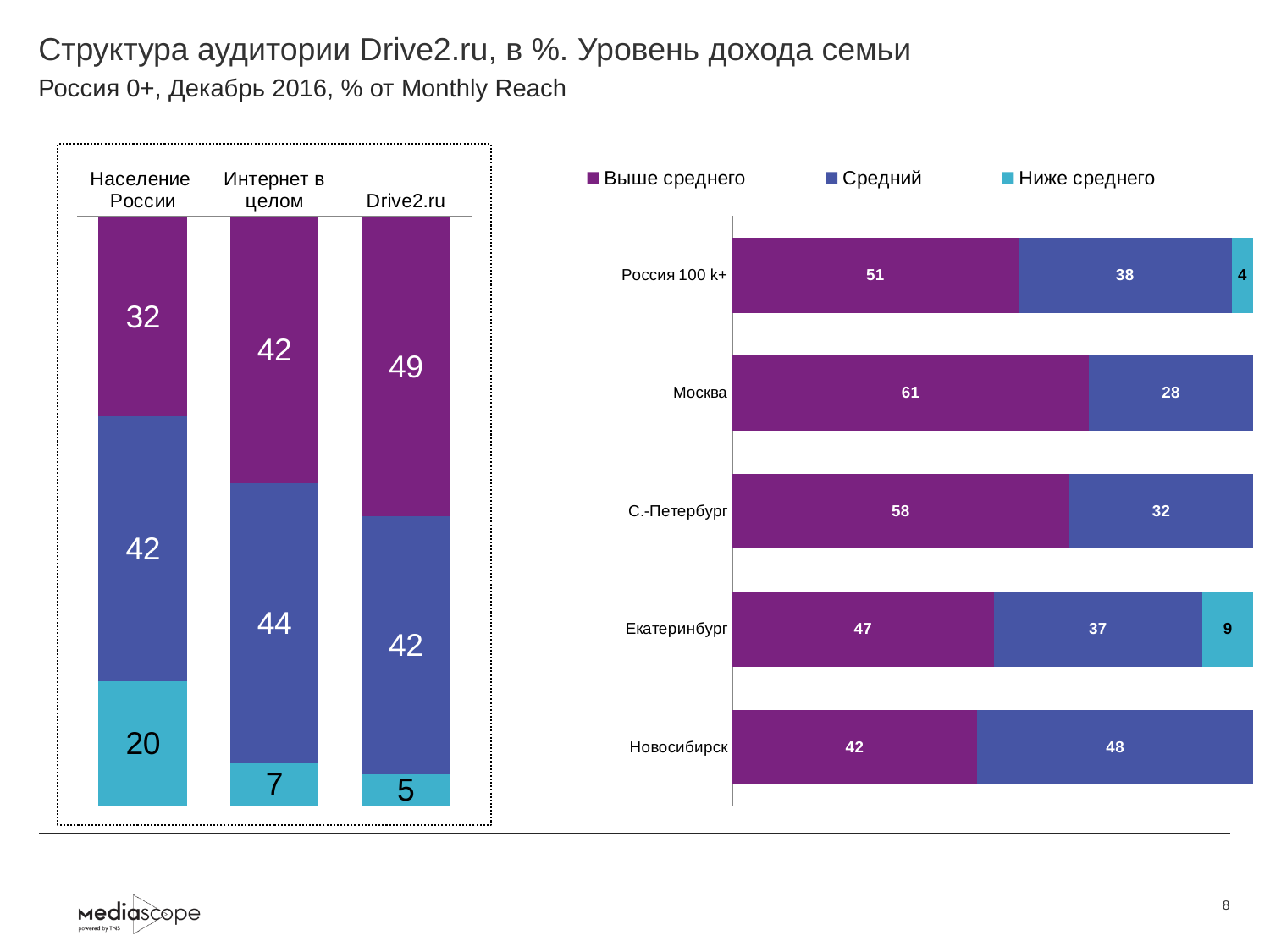
In the right chart, what is the 'Выше среднего' value for Москва? 61 In the right chart, what is the total of the labelled segments for Екатеринбург? 93 In the left chart, what is the value of the 'Средний' segment for Интернет в целом? 44 In the right chart, which city has the highest 'Выше среднего' value? Москва How many series does the legend of the right chart list? 3 In the left chart, which has a larger 'Выше среднего' value: Drive2.ru or Интернет в целом? Drive2.ru In the right chart, what is the 'Ниже среднего' value for Екатеринбург? 9 In the right chart, which category has the lowest 'Выше среднего' value? Новосибирск In the right chart, what is the difference between the 'Выше среднего' values for Москва and Новосибирск? 19 In the left chart, what is the value of the 'Ниже среднего' segment for Население России? 20 How many categories are shown in the right chart? 5 In the left chart, what is the value of the 'Выше среднего' segment for Drive2.ru? 49